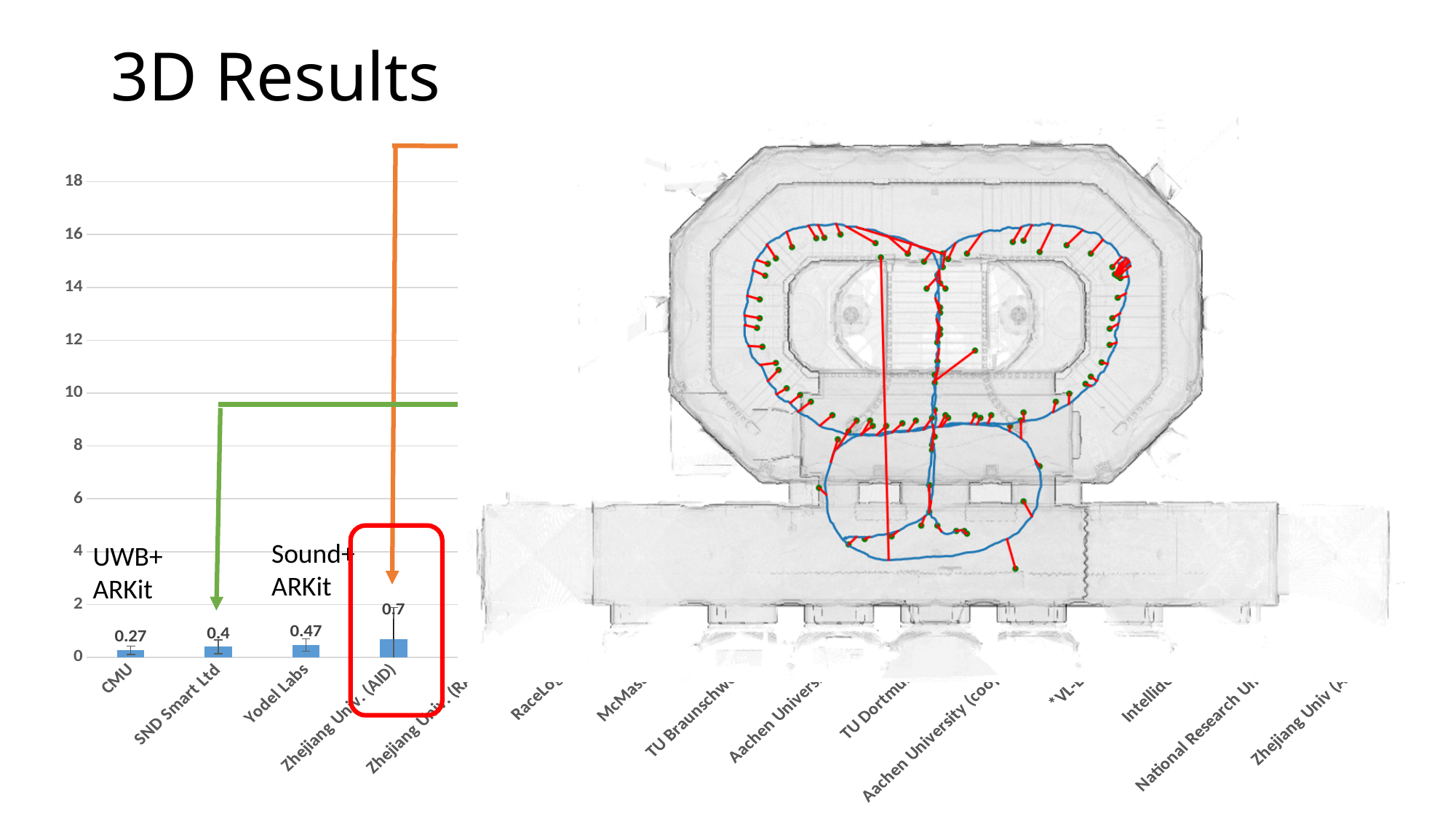
What is the value shown for CMU in the bar chart? 0.27 Is the value for Zhejiang Univ. (AID) greater or less than 2? less Which has a larger value, SND Smart Ltd or Yodel Labs? Yodel Labs What is the value shown for SND Smart Ltd in the bar chart? 0.4 What is the difference between the values for Yodel Labs and CMU? 0.2 What is the value shown for Zhejiang Univ. (AID) in the bar chart? 0.7 Among CMU, SND Smart Ltd, Yodel Labs and Zhejiang Univ. (AID), which has the lowest value? CMU Which category's bar is outlined with a red rounded box? Zhejiang Univ. (AID) What is the difference between the values for Zhejiang Univ. (AID) and SND Smart Ltd? 0.3 What kind of chart is shown on the left of the slide? bar chart Among CMU, SND Smart Ltd, Yodel Labs and Zhejiang Univ. (AID), which has the highest value? Zhejiang Univ. (AID) What is the value shown for Yodel Labs in the bar chart? 0.47